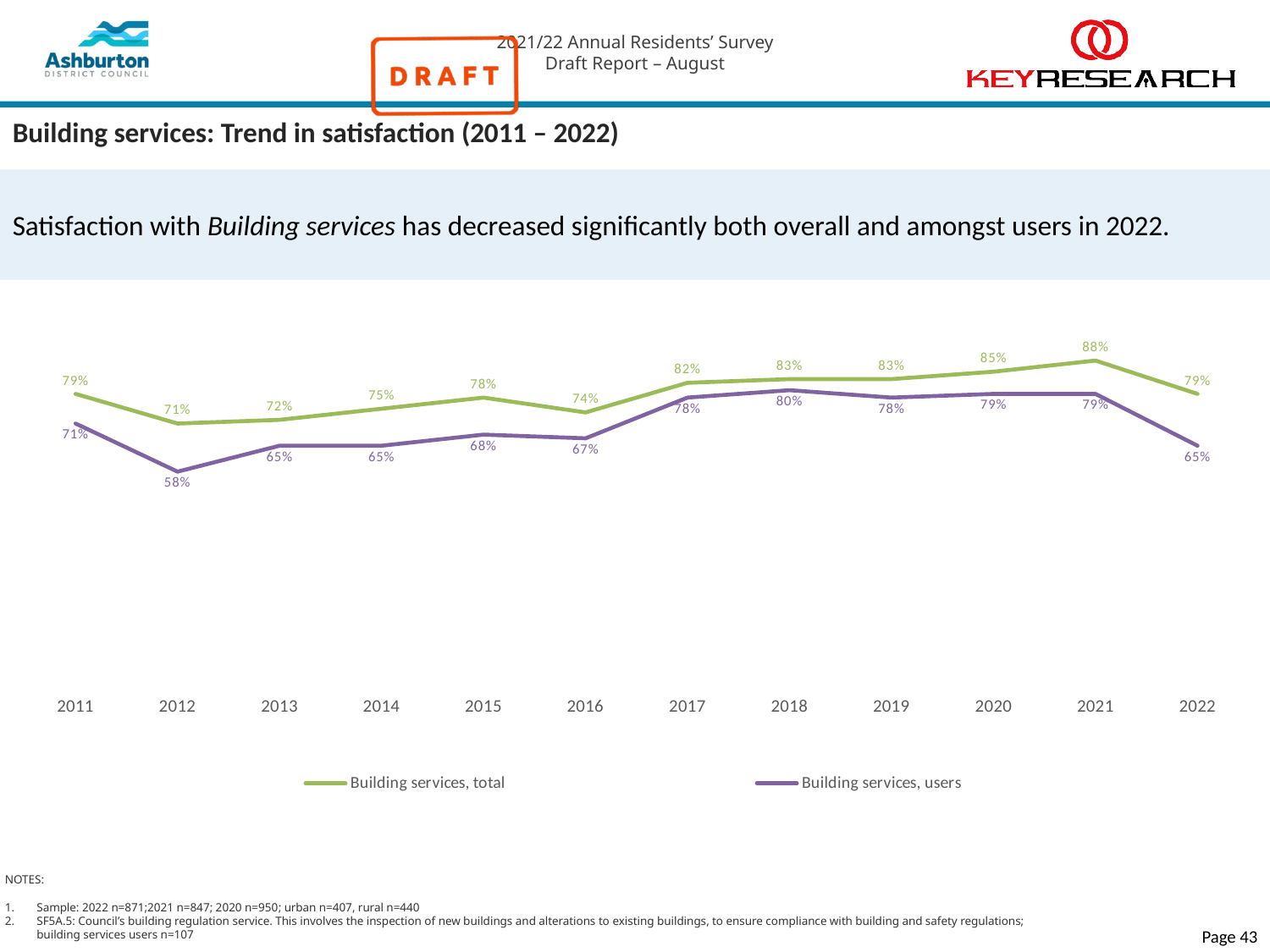
How many years are plotted along the x axis? 12 Did Building services, total rise or fall from 2021 to 2022? Fall In which year is Building services, users at its lowest? 2012 What is the title of the chart? Building services: Trend in satisfaction (2011 – 2022) What is the value for Building services, total in 2021? 88% What type of chart is shown on the slide? Line chart In which year is Building services, total at its highest? 2021 Which series has the higher value in 2018, Building services, total or Building services, users? Building services, total What is the value for Building services, users in 2022? 65% How many series does the legend list? 2 What is the difference between Building services, total and Building services, users in 2022? 14 percentage points What is the value for Building services, users in 2012? 58%